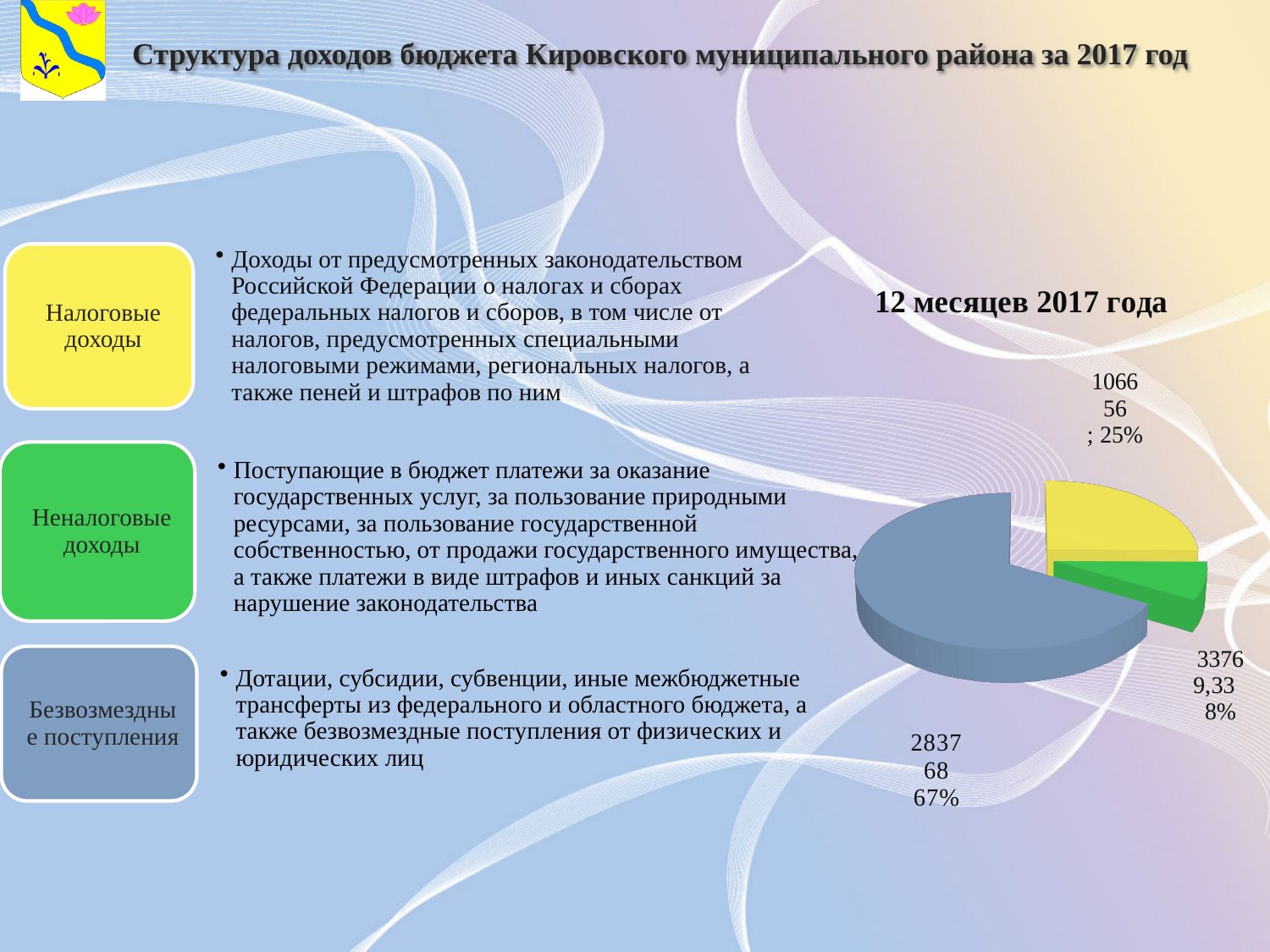
Is the share of the blue slice greater or less than 50%? greater How many slices does the pie chart have? 3 Which slice has a larger share, the yellow slice or the green slice? the yellow slice Which slice of the pie chart has the smallest share? the green slice (8%) What is the title of the pie chart? 12 месяцев 2017 года Which slice of the pie chart has the largest share? the blue slice (67%) What percentage share is shown for the blue slice of the pie chart? 67% What colour is the slice representing 25% of the pie chart? yellow What percentage share is shown for the green slice of the pie chart? 8% By how many percentage points does the blue slice's share exceed the yellow slice's share? 42 percentage points What percentage share is shown for the yellow slice of the pie chart? 25% What kind of chart is shown on the slide? pie chart